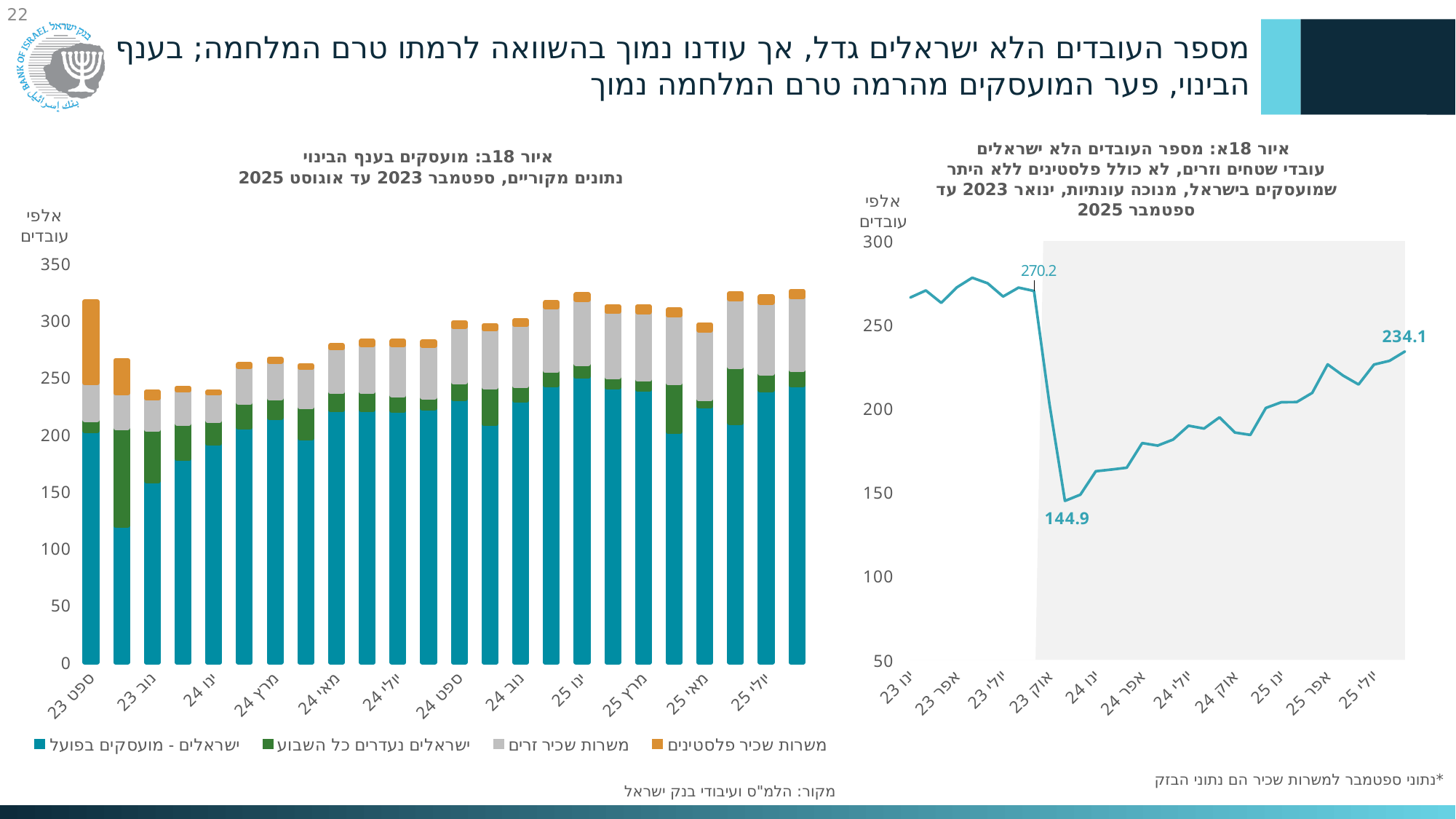
In the left-hand chart (איור 18ב), is the total height of the ספט 23 bar greater or less than 300? greater What kind of chart is the right-hand chart (איור 18א)? line chart What kind of chart is the left-hand chart (איור 18ב)? bar chart How many series does the legend of the left-hand chart (איור 18ב) list? 4 In the right-hand chart (איור 18א), how much lower is the final labelled value 234.1 than the pre-drop value 270.2? 36.1 In the right-hand chart (איור 18א), what is the difference between the labelled value 270.2 and the labelled low of 144.9? 125.3 In the right-hand chart (איור 18א), does the line rise or fall from the low point in late 2023 to the end of the series? rises In the right-hand chart (איור 18א), what value is labelled at the end of the line (September 2025)? 234.1 In the left-hand chart (איור 18ב), which month has the largest orange segment (משרות שכיר פלסטינים)? ספט 23 In the left-hand chart (איור 18ב), is the blue segment (ישראלים - מועסקים בפועל) for the second bar (October 2023) greater or less than 150? less In the right-hand chart (איור 18א), what is the lowest labelled value on the line? 144.9 In the right-hand chart (איור 18א), what value is labelled just before the sharp drop in late 2023? 270.2